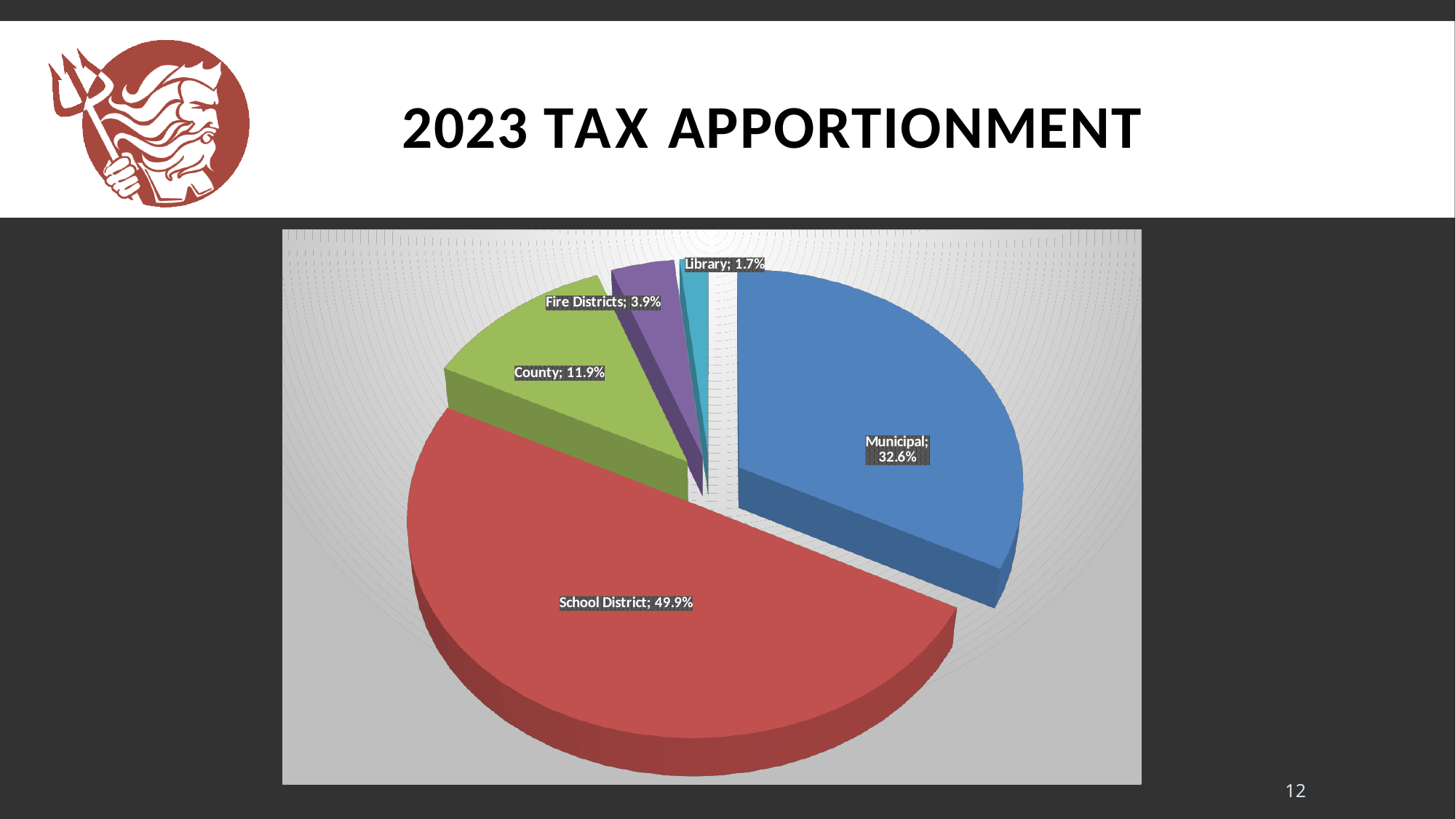
What share of the pie does Municipal have? 32.6% Which is larger, the County slice or the Fire Districts slice? County What share of the pie does Library have? 1.7% What is the difference in percentage points between the School District and Municipal slices? 17.3 What share of the pie does School District have? 49.9% What share of the pie does County have? 11.9% Which slice of the pie is the smallest? Library How many slices does the pie chart have? 5 What share of the pie does Fire Districts have? 3.9% What colour is the School District slice? Red What kind of chart is shown on the slide? Pie chart Which slice of the pie is the largest? School District